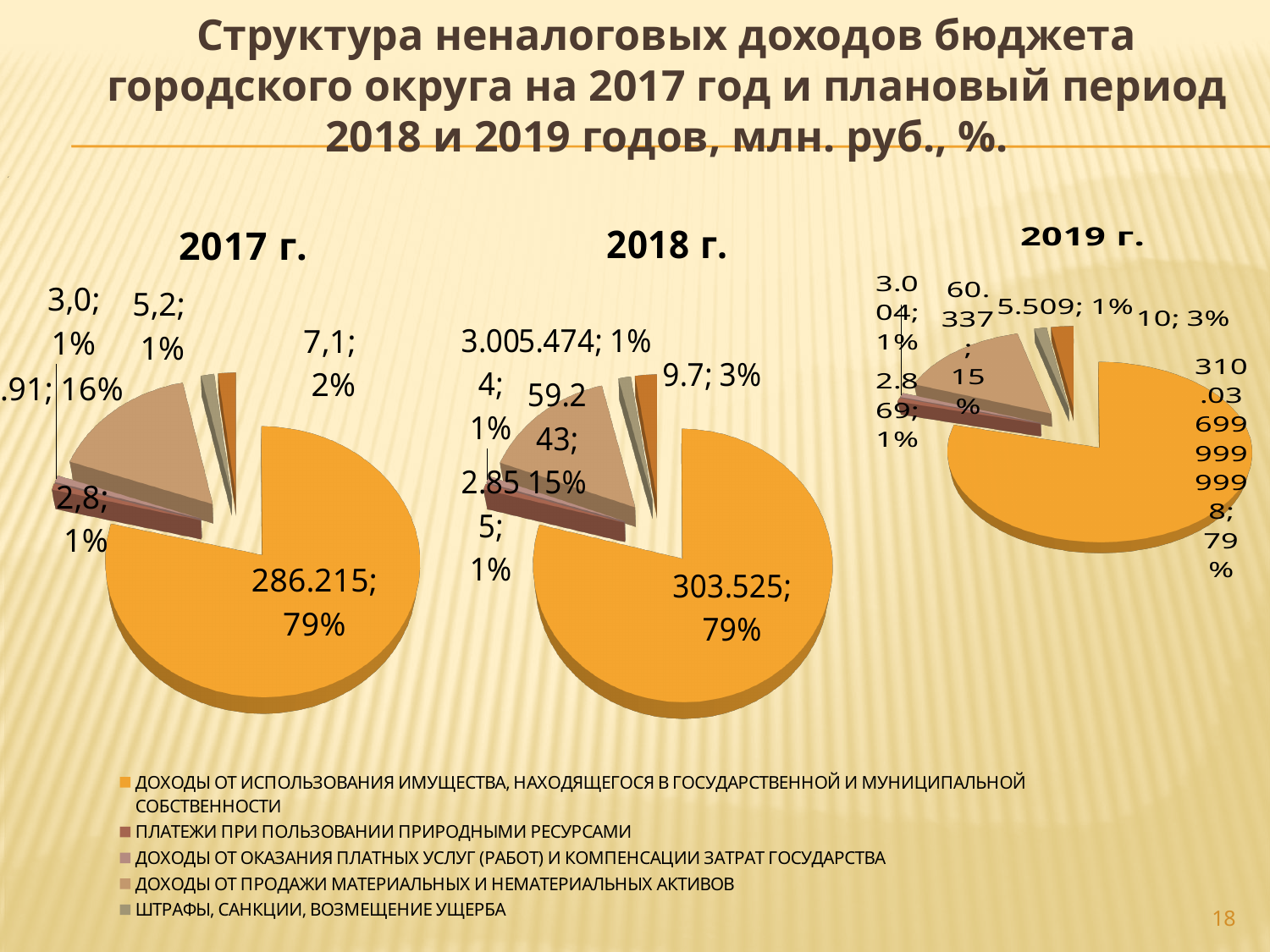
In the 2019 г. pie chart, what share does the largest slice have? 79% Which legend entry corresponds to the largest (orange) slice in each pie chart? ДОХОДЫ ОТ ИСПОЛЬЗОВАНИЯ ИМУЩЕСТВА, НАХОДЯЩЕГОСЯ В ГОСУДАРСТВЕННОЙ И МУНИЦИПАЛЬНОЙ СОБСТВЕННОСТИ In the 2019 г. pie chart, what is the value of the slice labelled 3%? 10 In the 2017 г. pie chart, what share does the largest slice have? 79% What kind of charts are shown on the slide? Pie charts In the 2018 г. pie chart, what is the value of the largest slice? 303.525 How many entries does the legend list? 5 How many pie charts are on the slide? 3 Which is larger: the largest slice in the 2017 г. chart (286.215) or the largest slice in the 2018 г. chart (303.525)? 2018 г. (303.525) In the 2019 г. pie chart, what is the value of the slice labelled 15%? 60.337 In the 2017 г. pie chart, what is the value of the largest slice? 286.215 In the 2018 г. pie chart, what is the value of the slice labelled 3%? 9.7